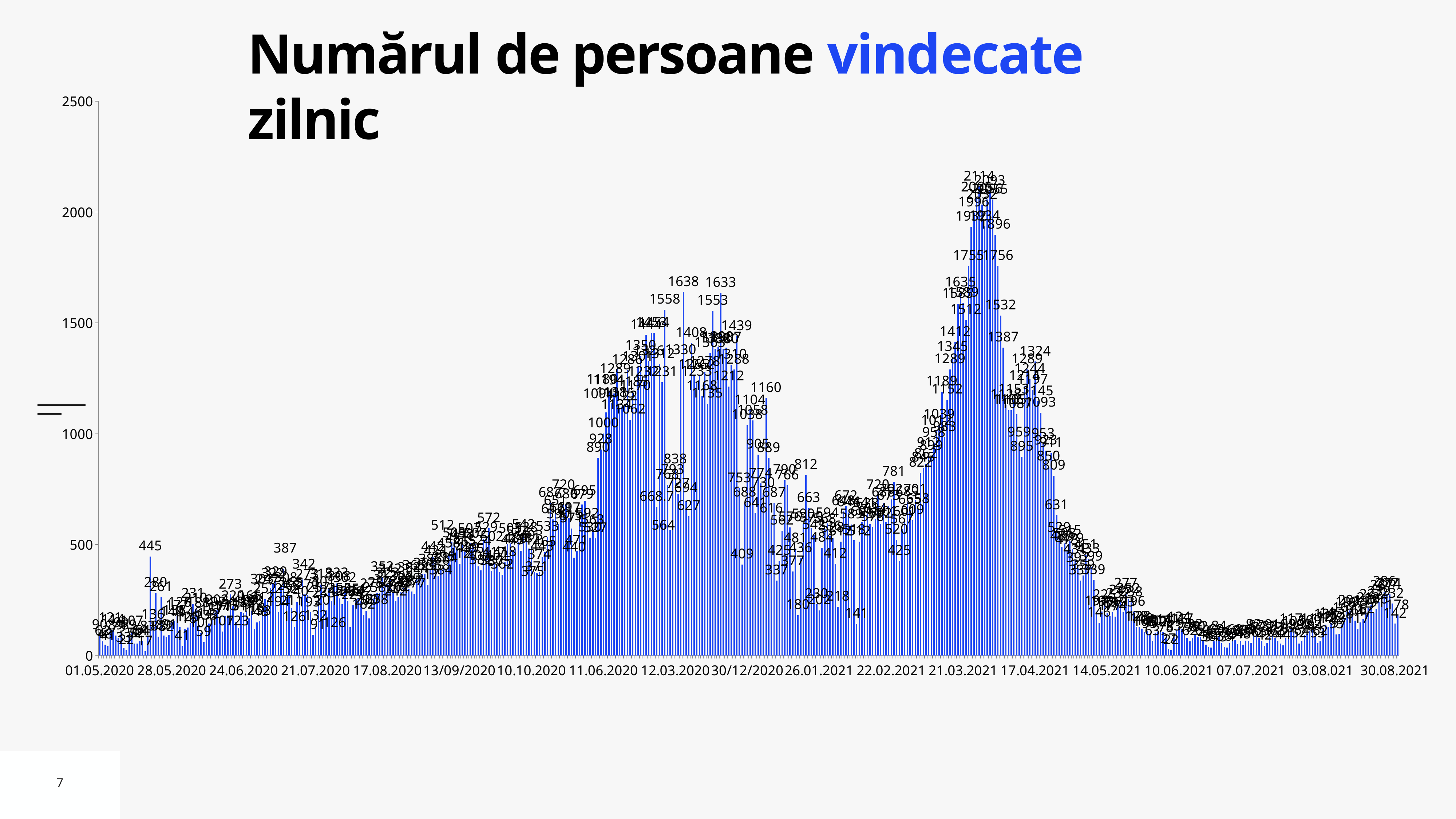
What kind of chart is shown on the slide? bar chart What is the highest data label value shown on the chart? 2114 What is the title of the chart? Numărul de persoane vindecate zilnic Is the value at 30.08.2021 greater or less than 1000? less Is the value at 01.05.2020 greater or less than 500? less Is the value at 10.06.2021 greater or less than 500? less Do the values rise or fall between 22.02.2021 and 21.03.2021? rise What is the maximum value shown on the vertical axis? 2500 Do the values rise or fall between 21.03.2021 and 14.05.2021? fall